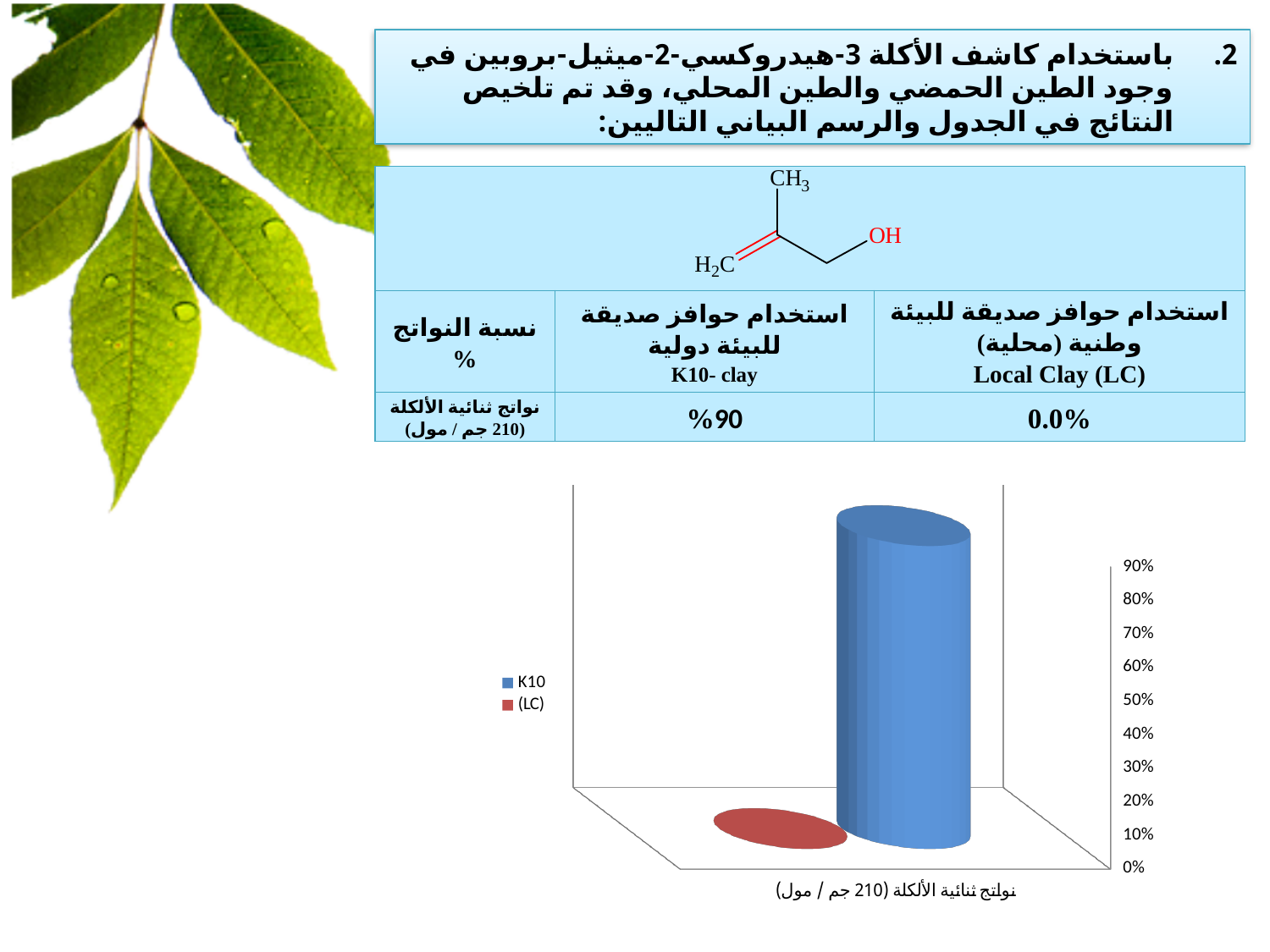
Which series in the chart has the higher value, K10 or (LC)? K10 How many series does the chart legend list? 2 What value does the (LC) bar reach on the chart's axis? 0% What is the highest value shown on the chart's vertical axis? 90% Is the value for K10 in the chart greater or less than 50%? greater Which series in the chart has the lowest value? (LC) What kind of chart is shown on the slide? bar chart Which series in the chart has the highest value? K10 What are the two series named in the chart legend? K10 and (LC) What value does the K10 bar reach on the chart's axis? 90% Is the value for (LC) in the chart greater or less than 10%? less What colour is the K10 bar in the chart? blue